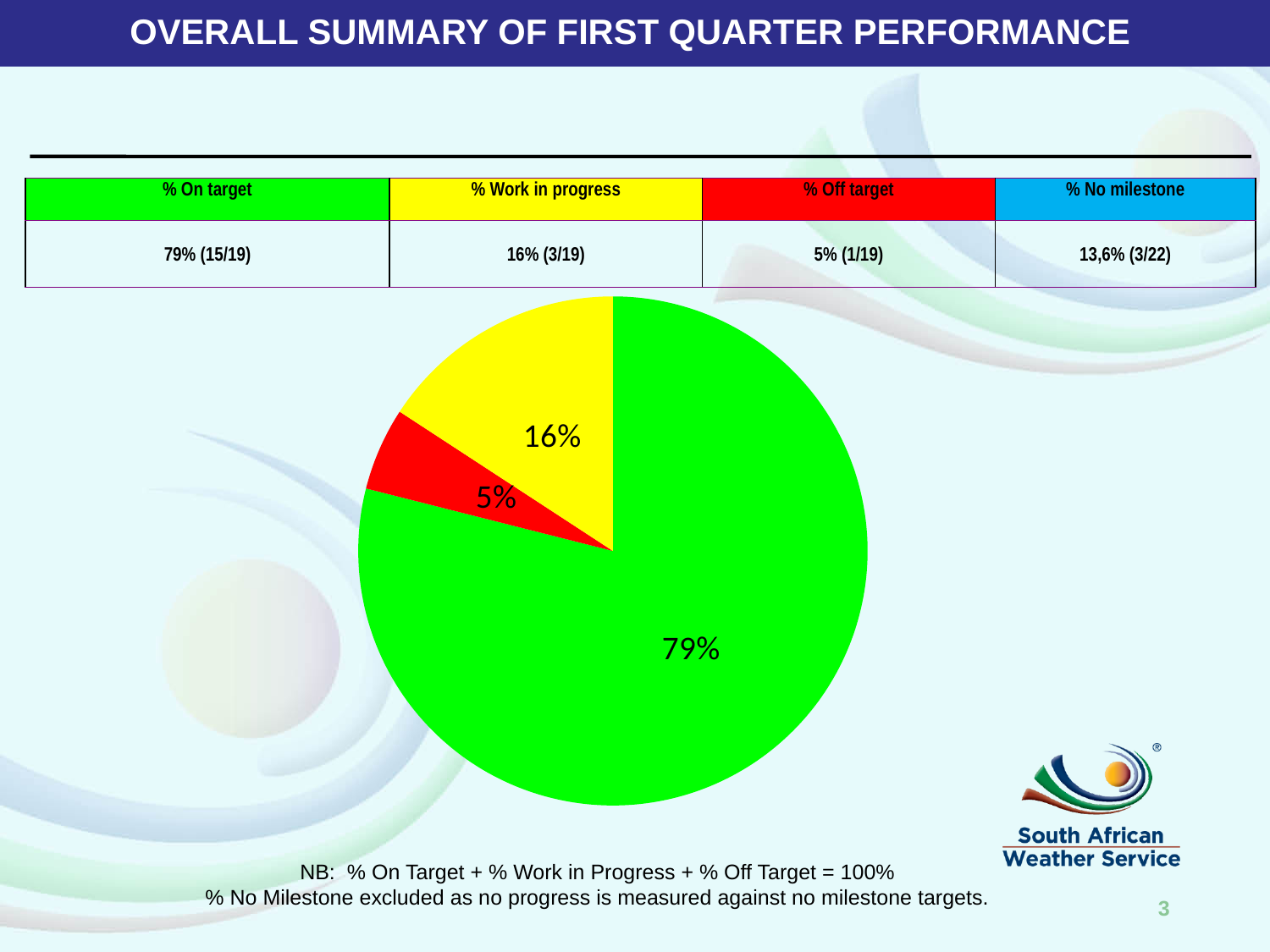
According to the table above the pie chart, which category does the red colour represent? % Off target What percentage is shown on the yellow slice of the pie chart? 16% What is the difference between the green slice and the yellow slice of the pie chart? 63% Which slice of the pie chart is the smallest? 5% (red, % Off target) What percentage is shown on the red slice of the pie chart? 5% How many slices does the pie chart have? 3 Which is larger in the pie chart, the yellow slice or the red slice? the yellow slice (16%) What is the difference between the yellow slice and the red slice of the pie chart? 11% According to the table above the pie chart, which category does the green colour represent? % On target Which slice of the pie chart is the largest? 79% (green, % On target) What kind of chart is shown on the slide? pie chart What percentage is shown on the green slice of the pie chart? 79%